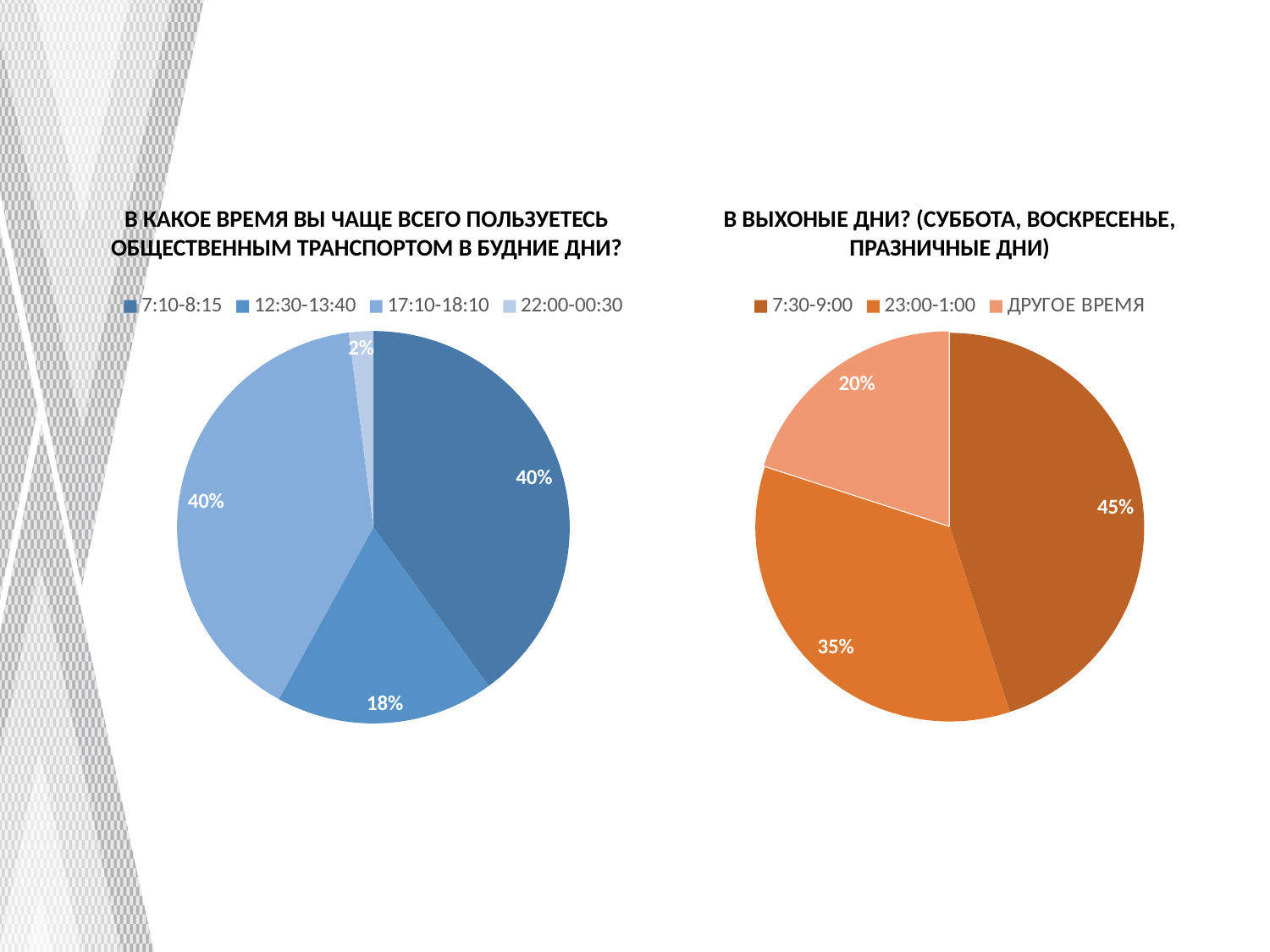
What type of chart is the right chart (weekends)? Pie chart In the left chart (weekdays), what is the difference between the 12:30-13:40 share and the 22:00-00:30 share? 16% In the left chart (weekdays), what share is shown for the 12:30-13:40 slice? 18% In the left chart (weekdays), which time slot has the smallest share? 22:00-00:30 In the right chart (weekends), which is larger: the share for 7:30-9:00 or for 23:00-1:00? 7:30-9:00 In the right chart (weekends), which category has the smallest share? ДРУГОЕ ВРЕМЯ In the right chart (weekends), what share is shown for 23:00-1:00? 35% In the left chart (weekdays), how many slices does the pie have? 4 In the right chart (weekends), which category has the largest share? 7:30-9:00 In the right chart (weekends), what is the difference between the 7:30-9:00 share and the ДРУГОЕ ВРЕМЯ share? 25% In the left chart (weekdays), what share is shown for the 22:00-00:30 slice? 2% How many entries does the legend of the right chart (weekends) list? 3